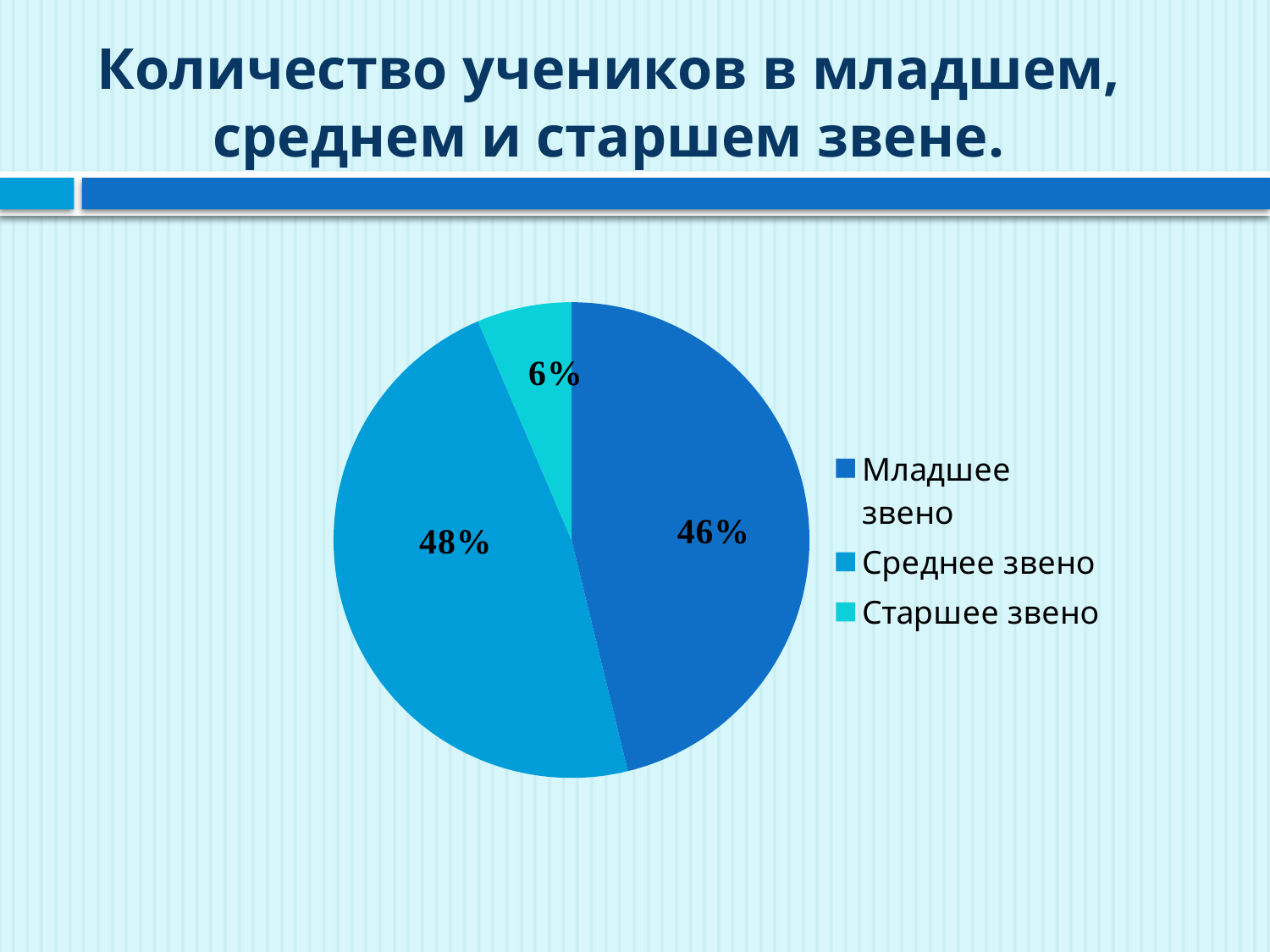
Which category has the largest slice of the pie? Среднее звено Which category has the smallest slice of the pie? Старшее звено Which is larger, the share for Младшее звено or the share for Среднее звено? Среднее звено What is the difference in percentage points between Среднее звено and Младшее звено? 2% What is the difference in percentage points between Младшее звено and Старшее звено? 40% What share of the pie does Среднее звено represent? 48% How many slices does the pie chart have? 3 What share of the pie does Старшее звено represent? 6% How many entries does the legend list? 3 What kind of chart is shown on the slide? Pie chart What is the title of the slide? Количество учеников в младшем, среднем и старшем звене. What share of the pie does Младшее звено represent? 46%